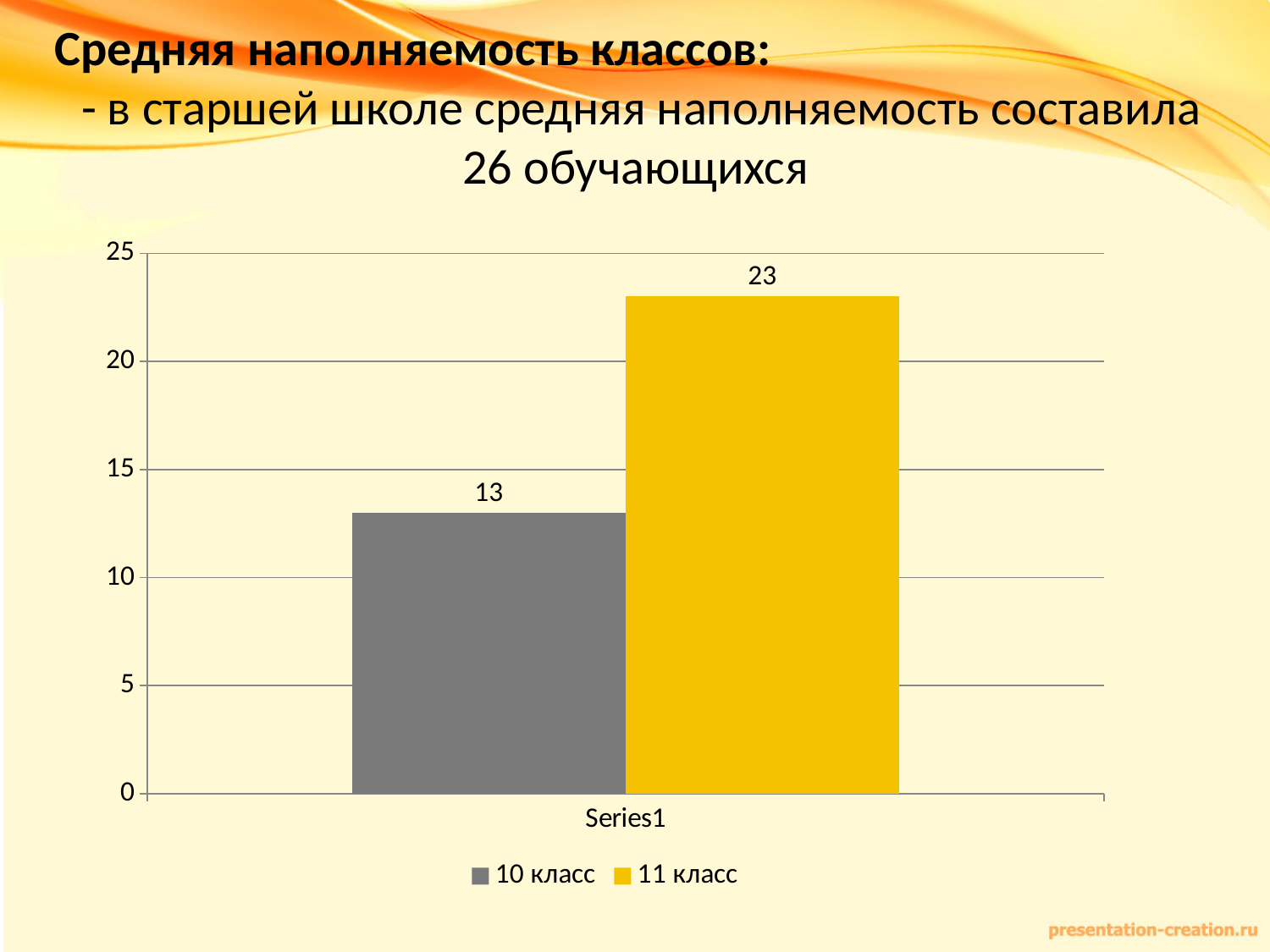
What is the difference between the values for 11 класс and 10 класс? 10 Which series has the lowest value? 10 класс Is the value for 10 класс greater or less than 15? less What kind of chart is shown on the slide? bar chart Which series has the highest value? 11 класс Is the value for 11 класс greater or less than 20? greater Which is larger, the value for 10 класс or the value for 11 класс? 11 класс What colour is the bar for 11 класс? yellow What is the category label shown on the x axis? Series1 How many series does the legend list? 2 What is the value for 11 класс? 23 What is the value for 10 класс? 13